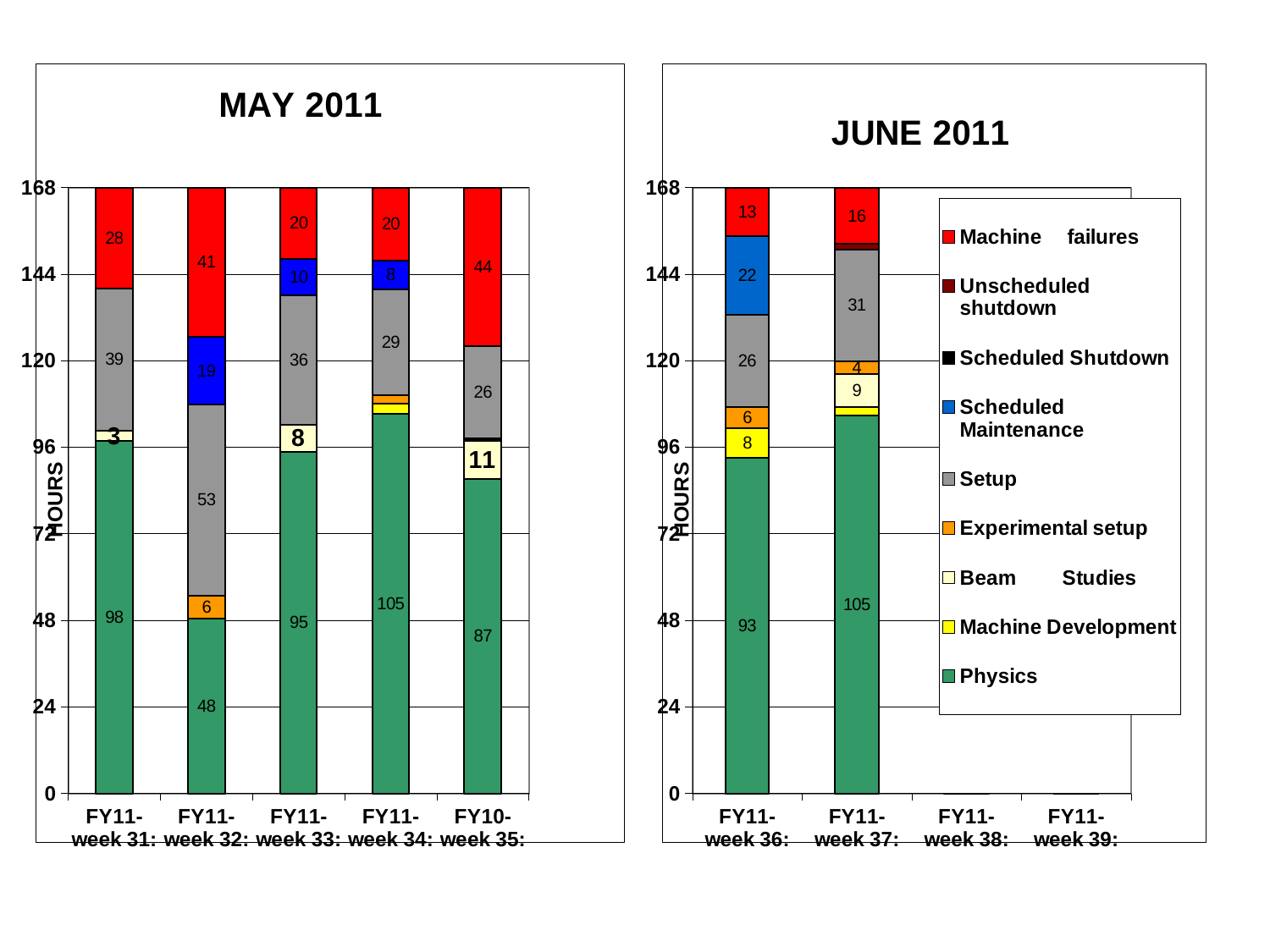
In the JUNE 2011 chart, how many hours of Scheduled Maintenance are shown for FY11-week 36? 22 What kind of chart is the MAY 2011 chart? Stacked bar chart In the MAY 2011 chart, which is larger: Machine failures for FY11-week 32 or for FY11-week 33? FY11-week 32 How many series does the legend on the JUNE 2011 chart list? 9 In the MAY 2011 chart, how many hours of Machine failures are shown for FY10-week 35? 44 In the MAY 2011 chart, which week has the lowest Physics value? FY11-week 32 In the JUNE 2011 chart, what is the difference in Physics hours between FY11-week 37 and FY11-week 36? 12 In the MAY 2011 chart, how many hours of Physics are shown for FY11-week 32? 48 In the JUNE 2011 chart, how many hours of Setup are shown for FY11-week 37? 31 How many week categories are labelled on the x axis of the MAY 2011 chart? 5 In the MAY 2011 chart, which week has the highest Physics value? FY11-week 34 In the MAY 2011 chart, what is the difference between the Setup hours for FY11-week 32 and FY11-week 33? 17